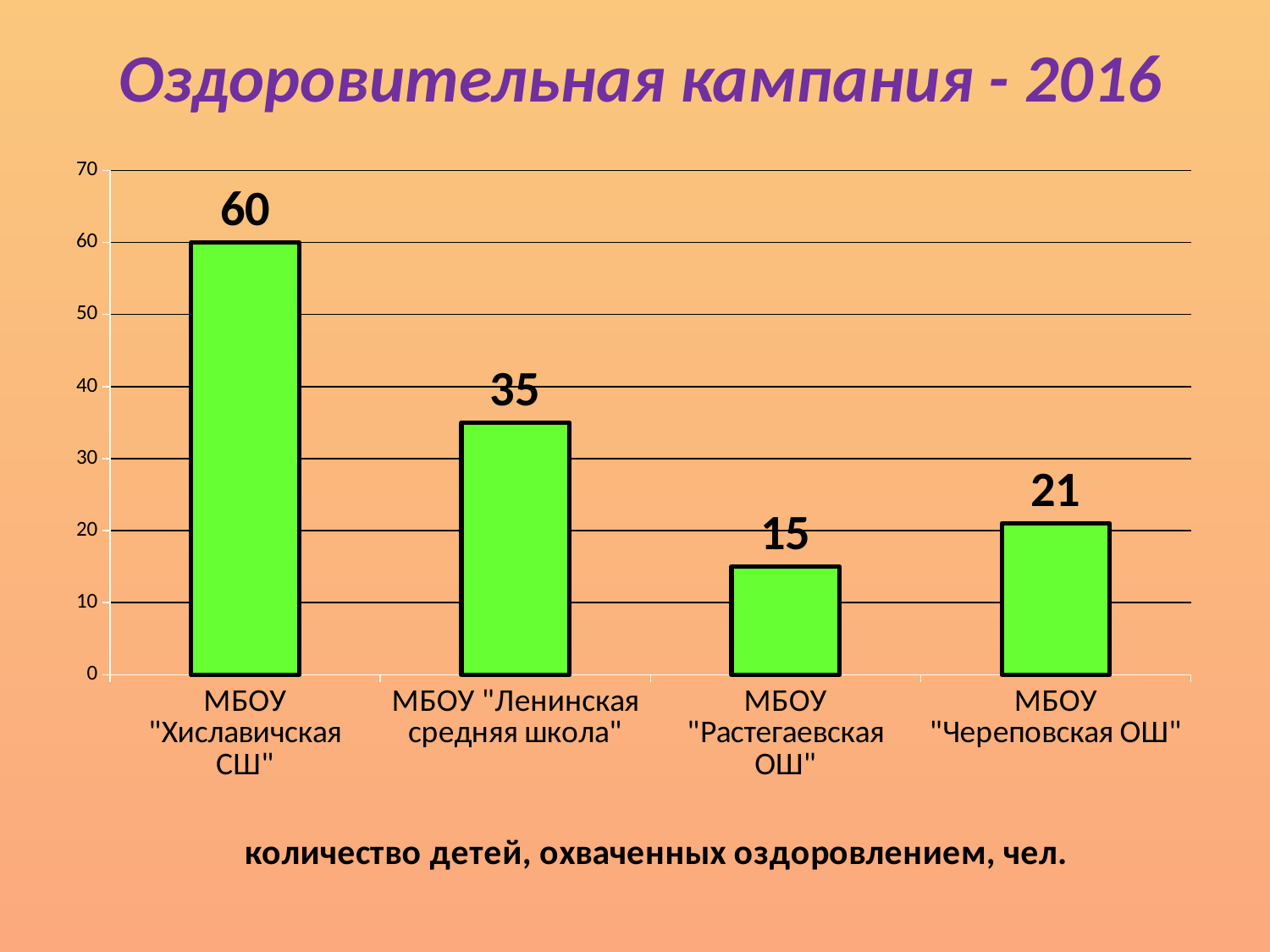
What is the difference between the values for МБОУ "Хиславичская СШ" and МБОУ "Ленинская средняя школа"? 25 What is the value for МБОУ "Ленинская средняя школа"? 35 Which school has the highest value? МБОУ "Хиславичская СШ" What is the value for МБОУ "Растегаевская ОШ"? 15 What is the value for МБОУ "Хиславичская СШ"? 60 What is the value for МБОУ "Череповская ОШ"? 21 Is the value for МБОУ "Ленинская средняя школа" greater or less than 30? greater How many schools are shown on the chart? 4 Which is larger: the value for МБОУ "Череповская ОШ" or МБОУ "Растегаевская ОШ"? МБОУ "Череповская ОШ" What is the title of the slide? Оздоровительная кампания - 2016 Which school has the lowest value? МБОУ "Растегаевская ОШ" What kind of chart is shown on the slide? bar chart